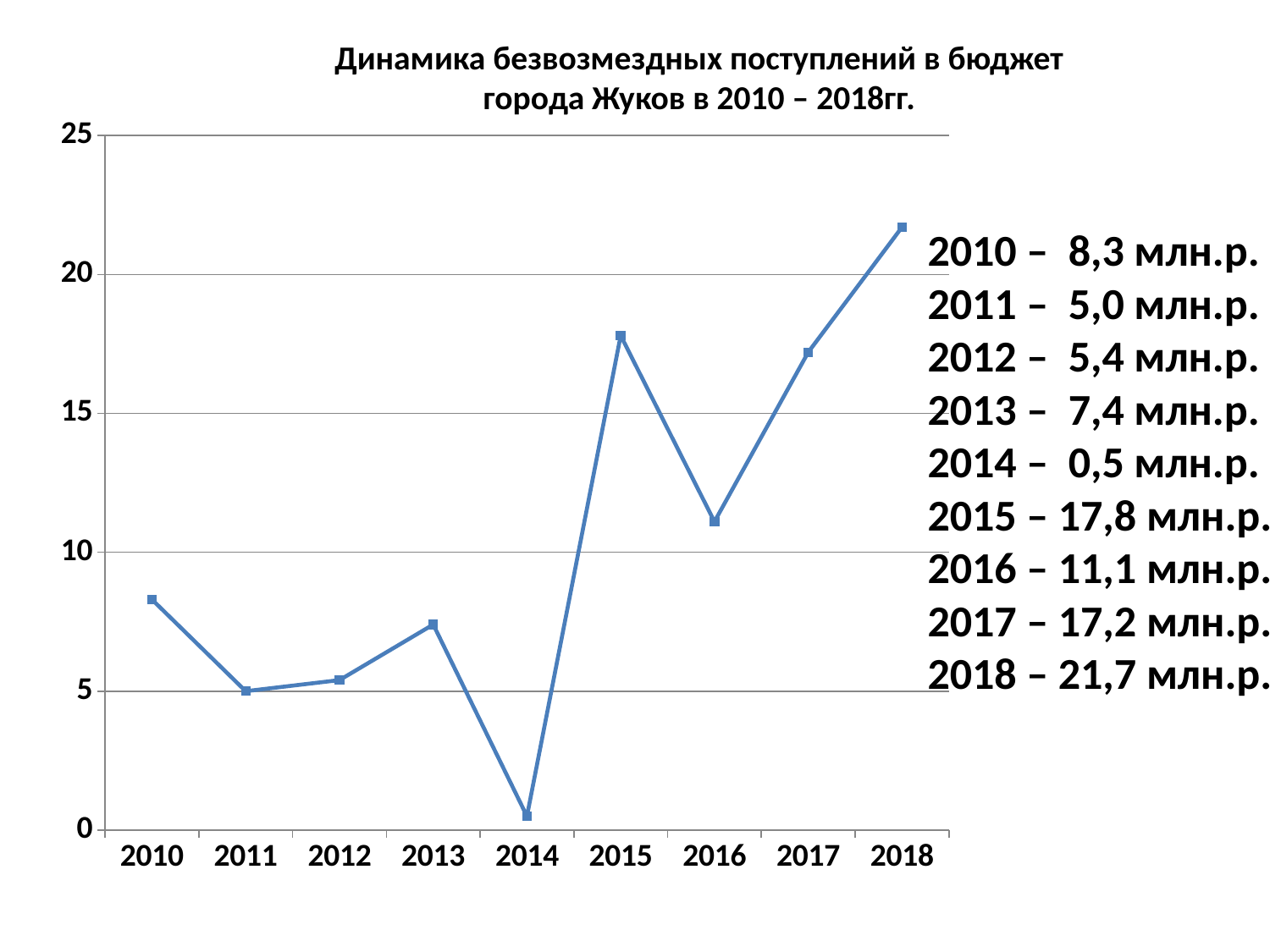
Which year has the highest value? 2018 Which year has the lowest value? 2014 What is the difference between the values for 2015 and 2016? 6,7 млн.р. What kind of chart is shown on the slide? line chart Is the value for 2016 greater or less than 10? greater What is the value for 2018? 21,7 млн.р. What is the value for 2014? 0,5 млн.р. Which is larger, the value for 2010 or the value for 2013? 2010 How many years are plotted on the x axis? 9 What is the difference between the values for 2018 and 2015? 3,9 млн.р. What is the value for 2015? 17,8 млн.р. Do the values rise or fall from 2016 to 2018? rise